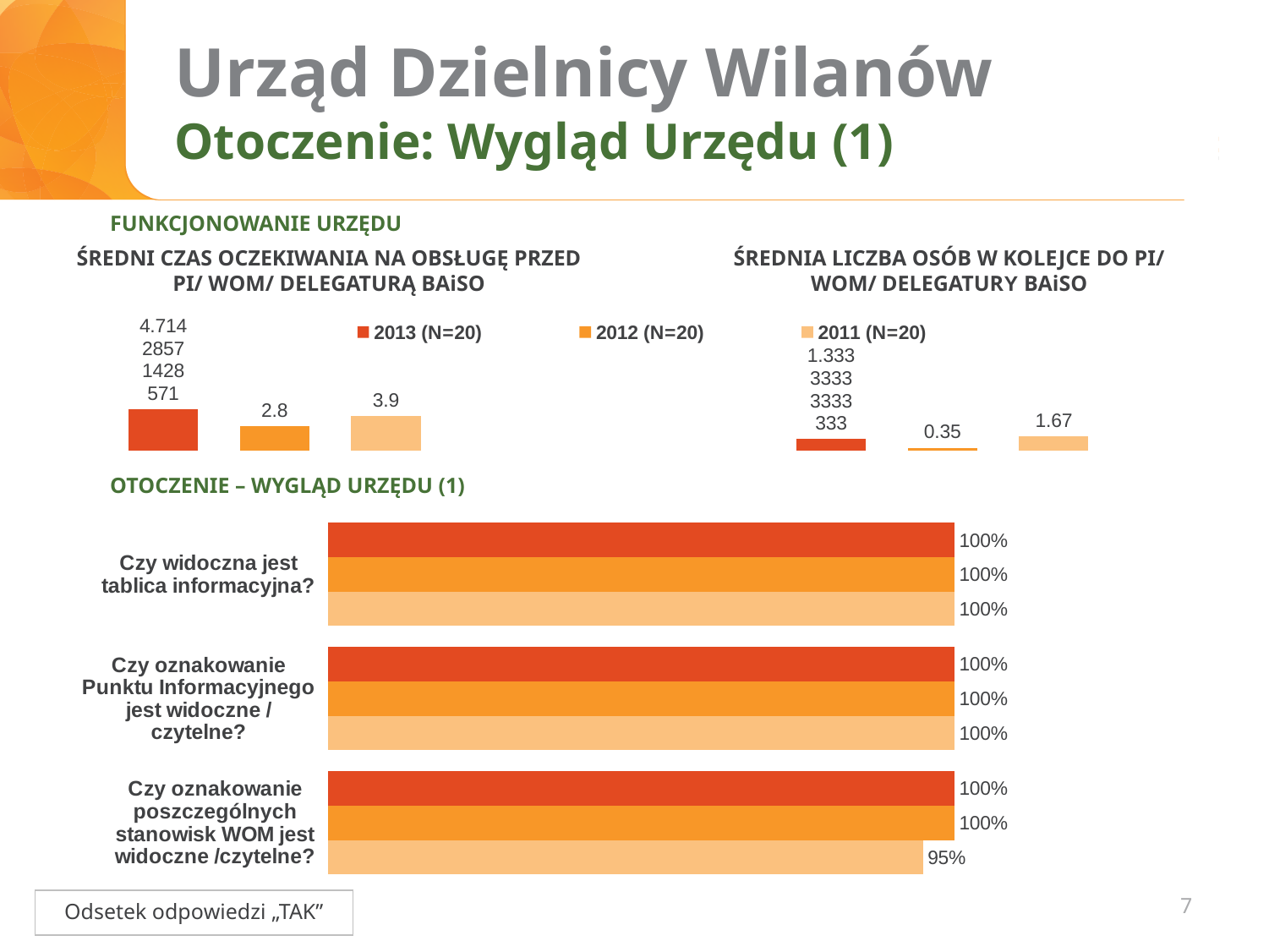
In the chart "Średni czas oczekiwania na obsługę przed PI/ WOM/ Delegaturą BAiSO", what is the value for 2011 (N=20)? 3.9 In the chart "Średni czas oczekiwania na obsługę przed PI/ WOM/ Delegaturą BAiSO", what is the value for 2012 (N=20)? 2.8 In the chart "Średnia liczba osób w kolejce do PI/ WOM/ Delegatury BAiSO", what is the value for 2012 (N=20)? 0.35 In the chart "Średni czas oczekiwania na obsługę przed PI/ WOM/ Delegaturą BAiSO", which year has the highest value? 2013 (N=20) In the bottom chart (Otoczenie – Wygląd Urzędu), what is the 2013 value for "Czy widoczna jest tablica informacyjna?"? 100% In the bottom chart (Otoczenie – Wygląd Urzędu), how many question categories are shown? 3 In the bottom chart (Otoczenie – Wygląd Urzędu), what is the 2011 value for "Czy oznakowanie poszczególnych stanowisk WOM jest widoczne /czytelne?"? 95% What type of chart is the bottom chart (Otoczenie – Wygląd Urzędu)? Bar chart In the chart "Średnia liczba osób w kolejce do PI/ WOM/ Delegatury BAiSO", what is the value for 2011 (N=20)? 1.67 In the chart "Średnia liczba osób w kolejce do PI/ WOM/ Delegatury BAiSO", which year has the lowest value? 2012 (N=20) How many series does the legend for the top charts list? 3 In the bottom chart (Otoczenie – Wygląd Urzędu), what is the difference between the 2013 and 2011 values for "Czy oznakowanie poszczególnych stanowisk WOM jest widoczne /czytelne?"? 5 percentage points